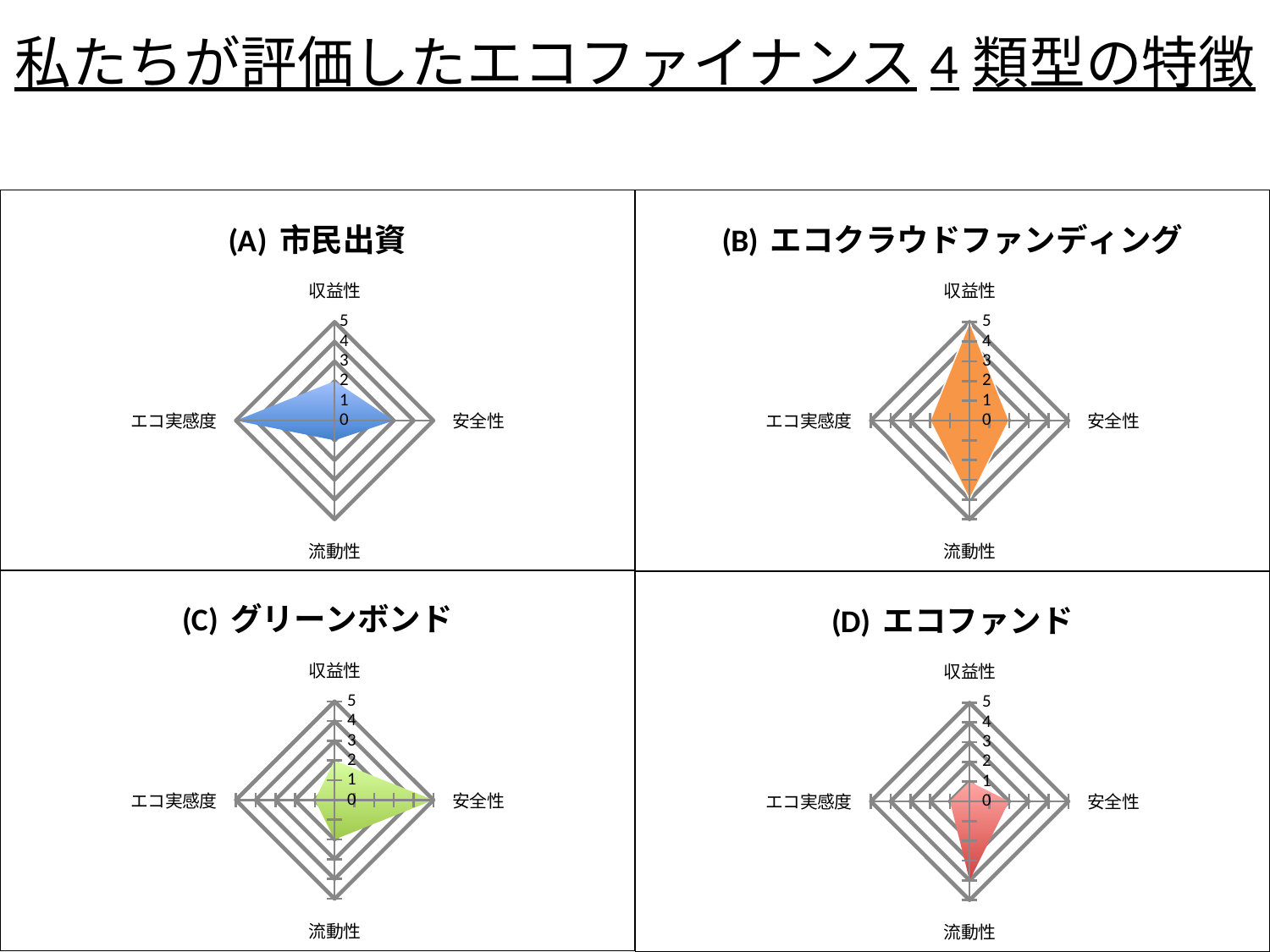
In the (B) エコクラウドファンディング chart, what is the value for 収益性? 5 In the (D) エコファンド chart, is the value for 流動性 greater or less than 3? greater What kind of chart is used in each of the four panels on the slide? radar chart In the (C) グリーンボンド chart, which axis has the highest value? 安全性 In the (A) 市民出資 chart, what is the value for エコ実感度? 5 In the (A) 市民出資 chart, which axis has the highest value? エコ実感度 In the (B) エコクラウドファンディング chart, which axis has the highest value? 収益性 In the (C) グリーンボンド chart, what is the value for 安全性? 5 How many axes (categories) does the (A) 市民出資 radar chart have? 4 How many radar charts are shown on the slide? 4 In the (A) 市民出資 chart, is the value for 流動性 greater or less than 3? less